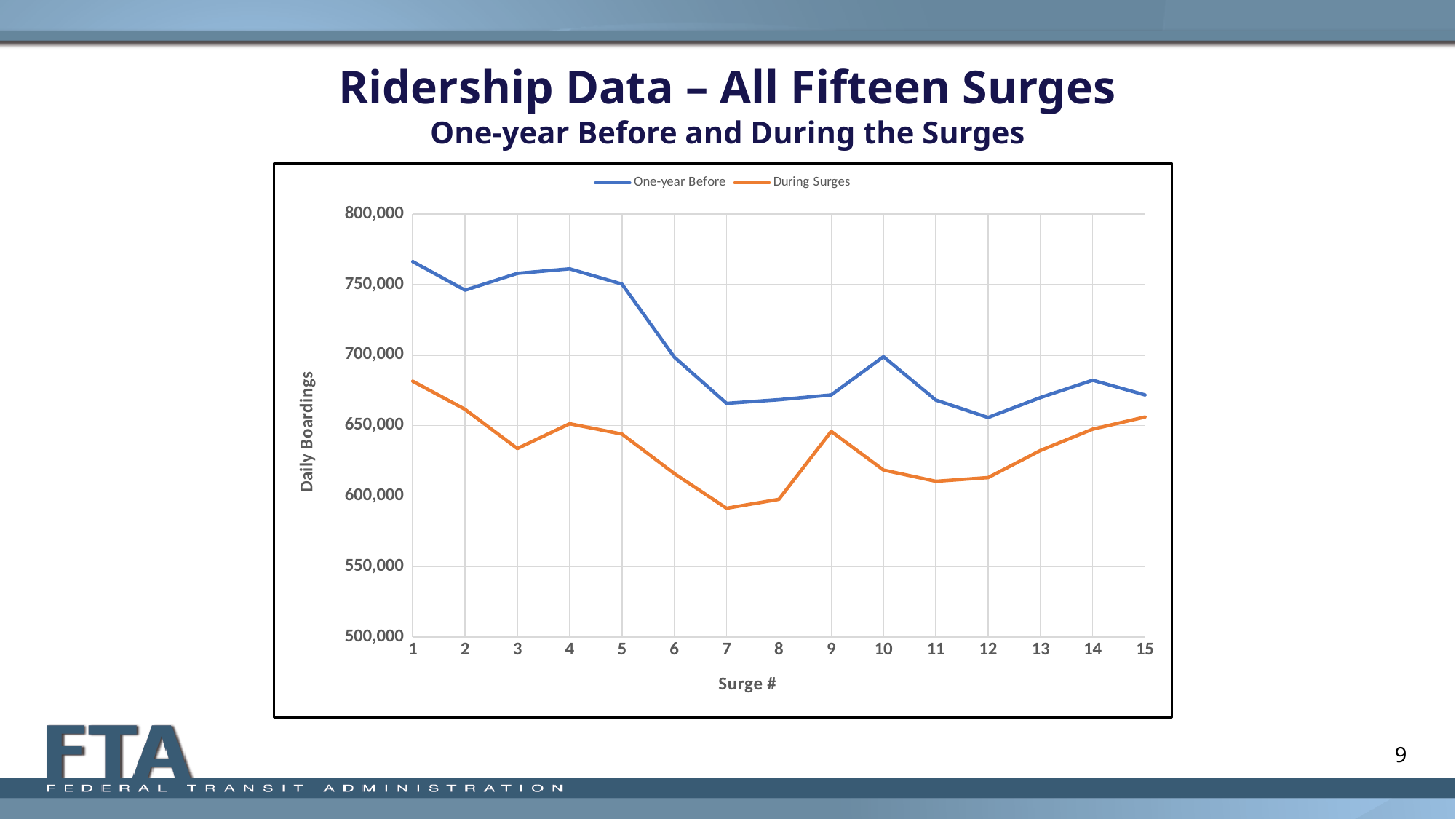
Which surge has the lowest value for the During Surges series? 7 Which surge has the lowest value for the One-year Before series? 12 Which surge has the highest value for the During Surges series? 1 How many series does the legend list? 2 Is the One-year Before value for surge 1 greater or less than 750,000? greater Is the During Surges value for surge 7 greater or less than 600,000? less How many surges are plotted along the x axis? 15 What is the title of the vertical axis? Daily Boardings Does the One-year Before series rise or fall from surge 4 to surge 7? fall Is the During Surges value for surge 3 greater or less than 650,000? less What kind of chart is shown on the slide? line chart At surge 7, which series has the larger value, One-year Before or During Surges? One-year Before